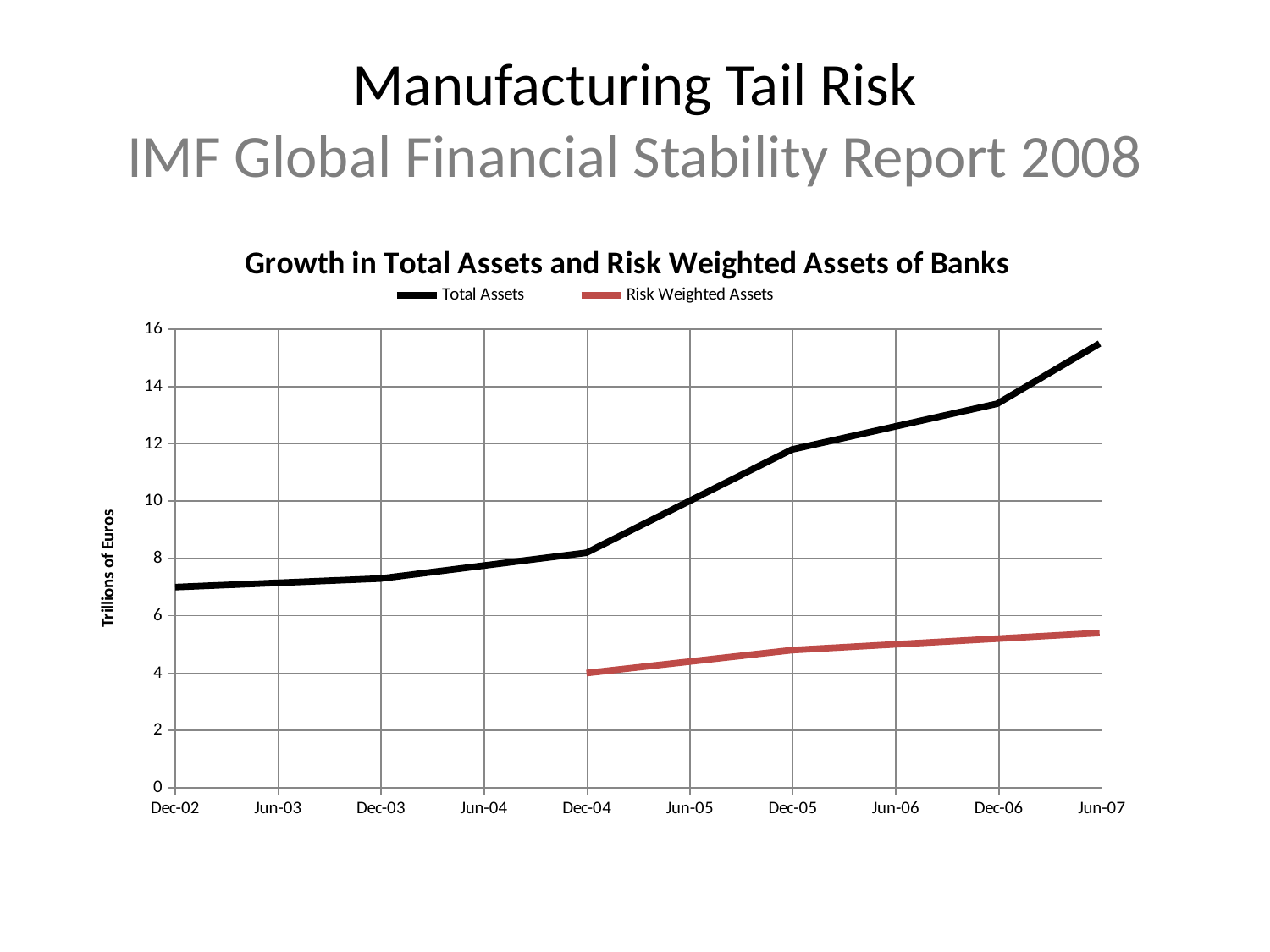
At Jun-07, which series has the larger value, Total Assets or Risk Weighted Assets? Total Assets What kind of chart is shown on the slide? Line chart Do the Total Assets values rise or fall from Dec-02 to Jun-07? Rise How many series does the chart legend list? 2 Is the Total Assets value at Dec-05 greater or less than 10? greater What is the title of the y axis of the chart? Trillions of Euros At which time point is the Total Assets line at its lowest? Dec-02 Is the Total Assets value at Dec-02 greater or less than 8? less Is the Risk Weighted Assets value at Jun-07 greater or less than 6? less At which time point is the Total Assets line at its highest? Jun-07 How many time points are labelled on the x axis of the chart? 10